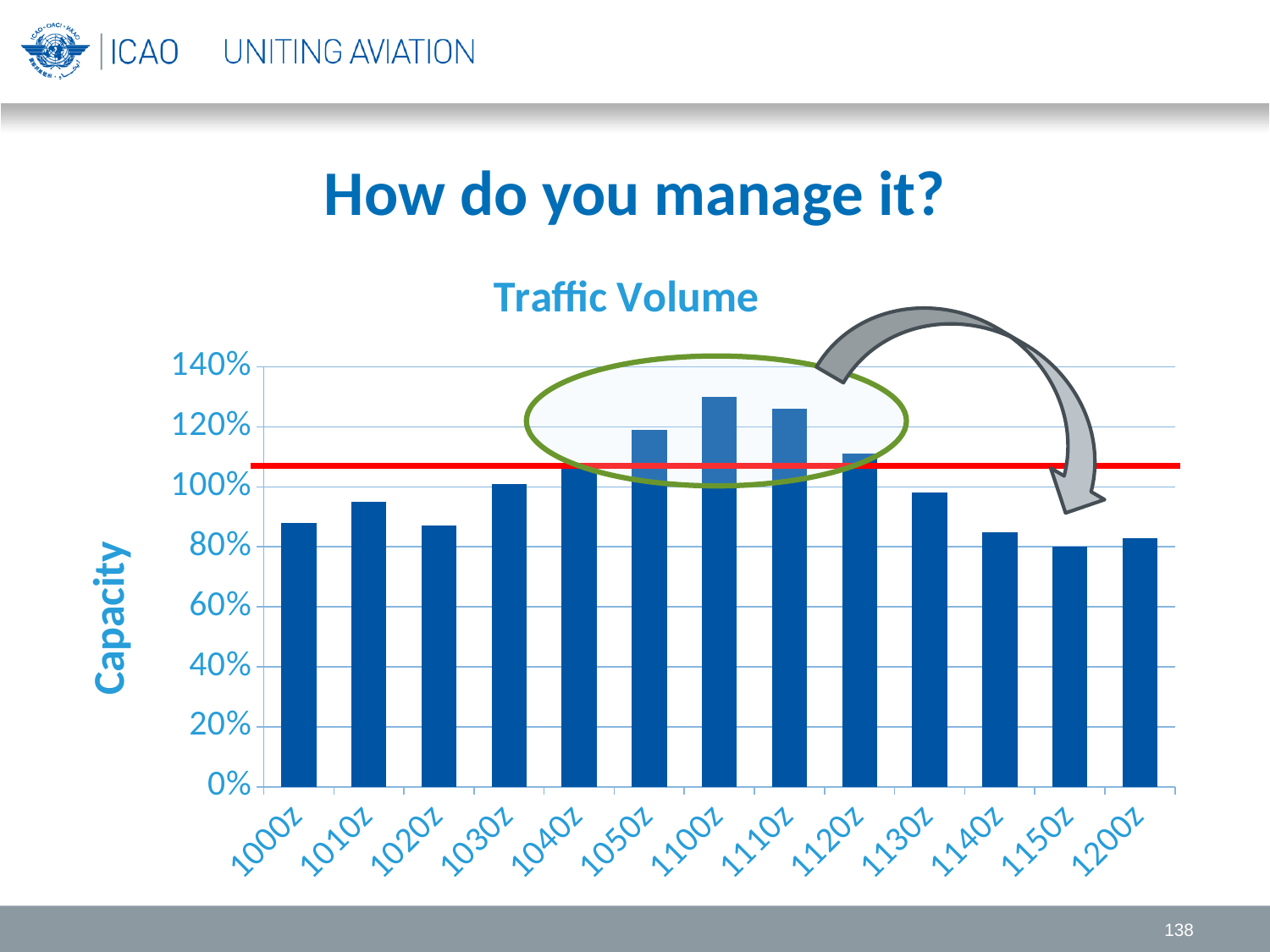
Which is larger, the value for 1100Z or the value for 1000Z? 1100Z What is the label on the vertical axis of the chart? Capacity Is the value for 1050Z greater or less than 100%? greater How many time categories are shown on the x axis of the chart? 13 Is the value for 1100Z greater or less than 120%? greater What is the title of the chart? Traffic Volume Is the value for 1000Z greater or less than 100%? less Do the values rise or fall from 1100Z to 1150Z? fall Which time has the highest traffic volume? 1100Z What type of chart is shown on the slide? bar chart Which is larger, the value for 1010Z or the value for 1020Z? 1010Z